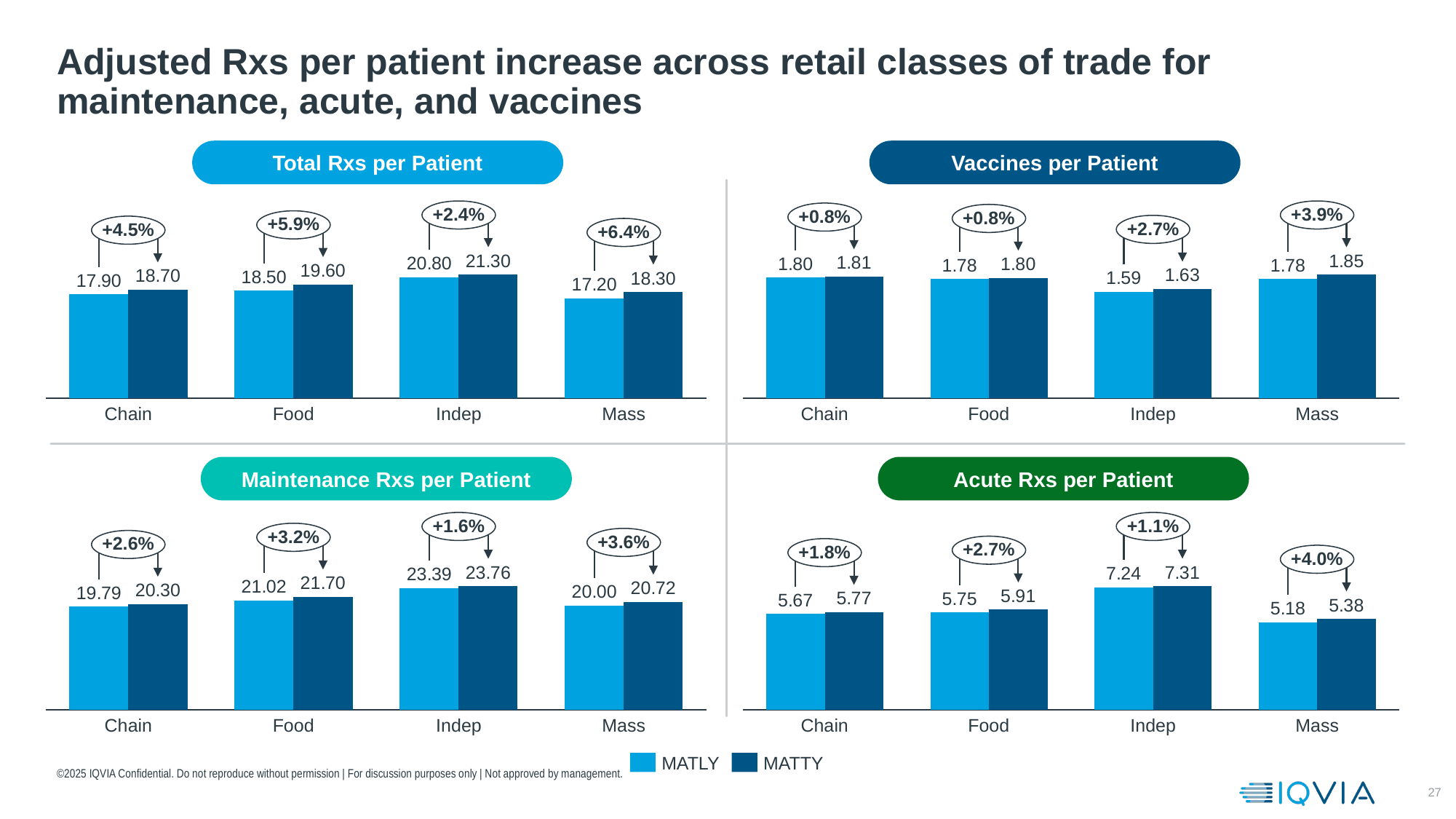
In the Total Rxs per Patient chart, what is the MATTY value for Food? 19.60 In the Maintenance Rxs per Patient chart, what is the difference between the MATTY values for Food and Chain? 1.40 What kind of chart is the Total Rxs per Patient chart? Bar chart In the Total Rxs per Patient chart, which category has the lowest MATLY value? Mass How many categories are shown on the x axis of the Acute Rxs per Patient chart? 4 In the Maintenance Rxs per Patient chart, which category has the highest MATTY value? Indep In the Vaccines per Patient chart, which is larger: the MATTY value for Mass or the MATTY value for Chain? Mass In the Vaccines per Patient chart, what is the MATLY value for Indep? 1.59 In the Total Rxs per Patient chart, what percentage change is shown for Mass? +6.4% In the Acute Rxs per Patient chart, what is the difference between the MATTY and MATLY values for Indep? 0.07 How many series does the legend list? 2 In the Acute Rxs per Patient chart, what is the MATTY value for Mass? 5.38